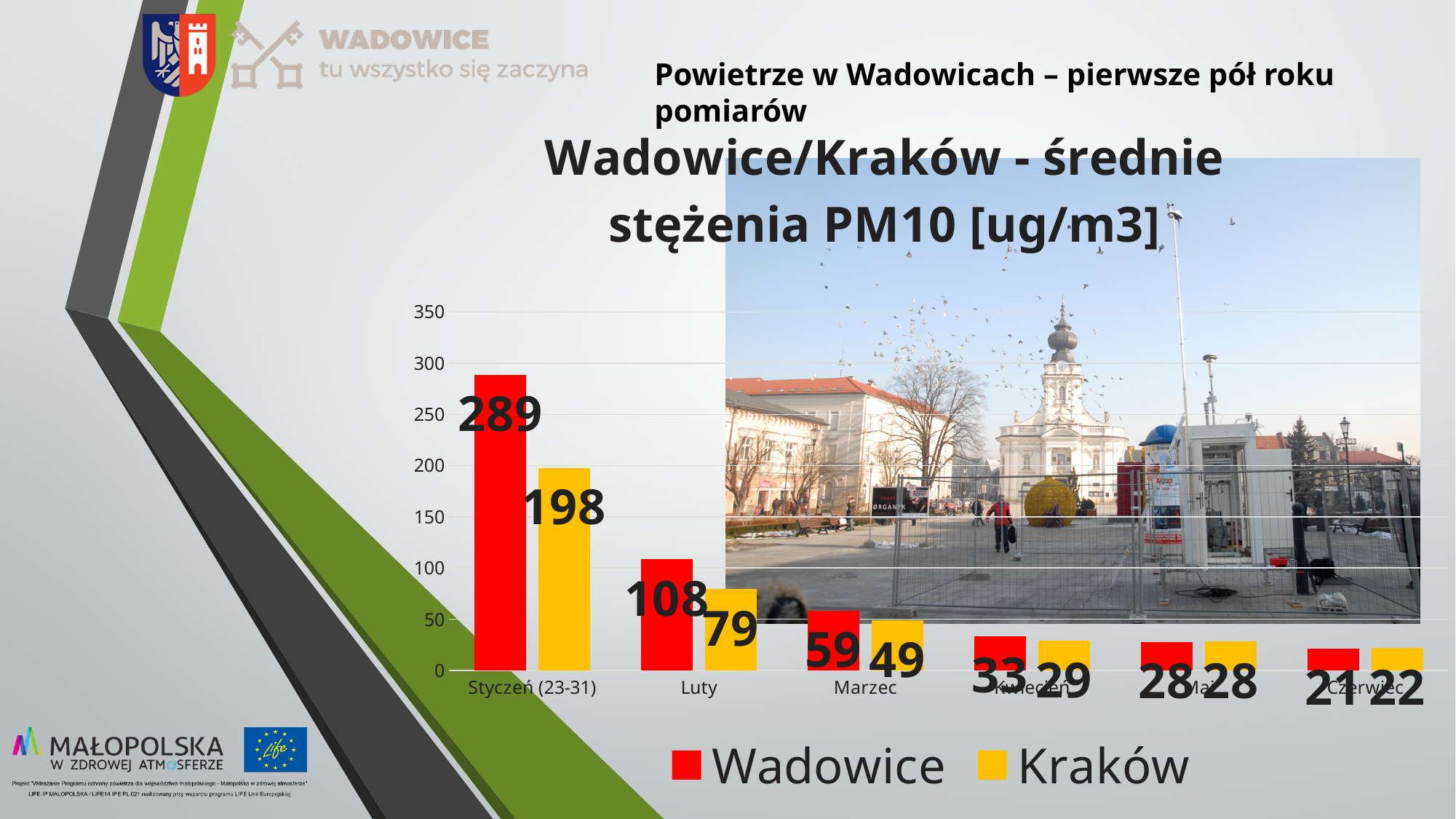
What is the Kraków value for Czerwiec? 22 Which month has the lowest Kraków value? Czerwiec What is the Kraków value for Luty? 79 For Luty, which is larger: the Wadowice value or the Kraków value? Wadowice Do the Wadowice values rise or fall from Styczeń to Czerwiec? Fall What is the Wadowice value for Marzec? 59 How many months are shown on the x axis? 6 How many series does the legend list? 2 What is the difference between the Wadowice and Kraków values for Styczeń (23-31)? 91 What is the Wadowice value for Styczeń (23-31)? 289 What kind of chart is shown? Bar chart Which month has the highest Wadowice value? Styczeń (23-31)